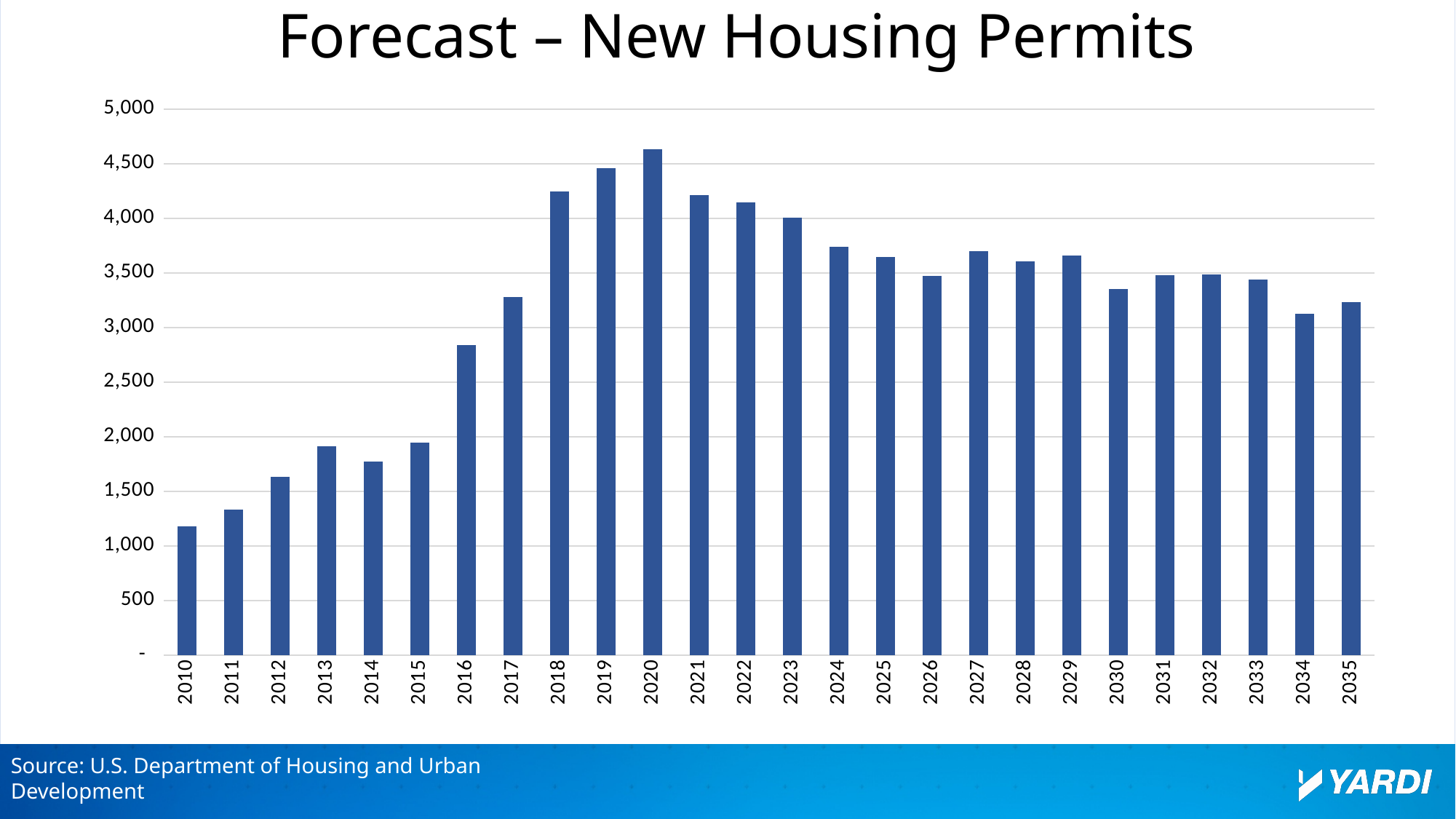
What type of chart is shown on the slide? Bar chart What is the title of the chart? Forecast – New Housing Permits Which year has the lowest number of new housing permits? 2010 Which year has the highest number of new housing permits? 2020 Is the value for 2010 greater or less than 1,500? less Is the value for 2018 greater or less than 4,000? greater Which year has a larger value, 2019 or 2021? 2019 Do the values generally rise or fall from 2010 to 2020? rise How many years are shown on the x axis? 26 Is the value for 2030 greater or less than 3,500? less Which year has a larger value, 2013 or 2014? 2013